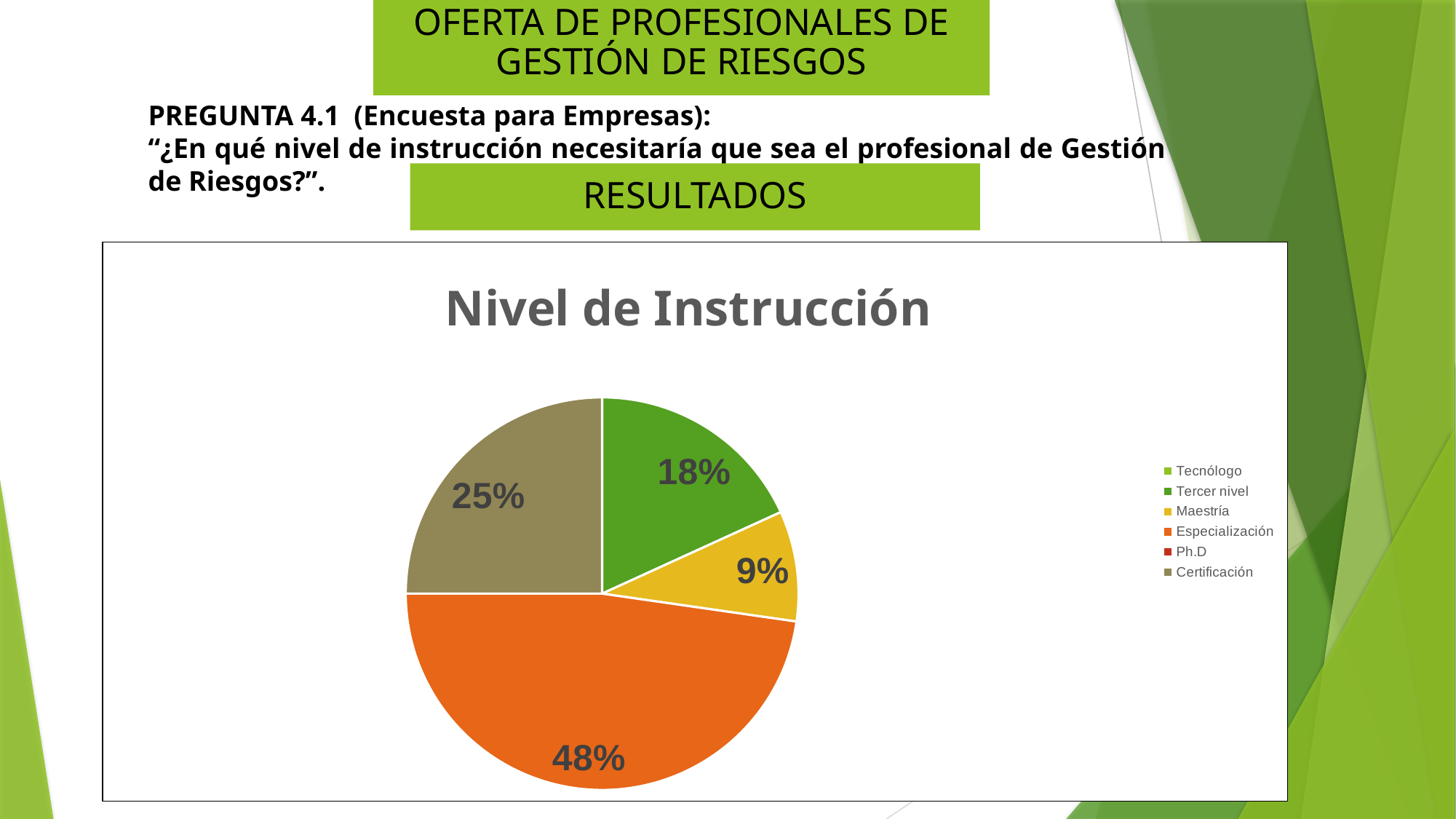
What type of chart is shown on the slide? Pie chart Which is larger, the slice for Certificación or the slice for Tercer nivel? Certificación What share does Certificación have in the Nivel de Instrucción pie chart? 25% How many categories does the legend of the chart list? 6 What is the difference between the Tercer nivel and Maestría slices? 9% What percentage is shown for Tercer nivel? 18% How many percentage points larger is Especialización than Certificación? 23% Is the share for Especialización greater or less than 50%? less Which category has the largest slice of the pie chart? Especialización What is the value shown for Maestría? 9% What percentage of the pie chart is Especialización? 48% What is the title of the chart? Nivel de Instrucción